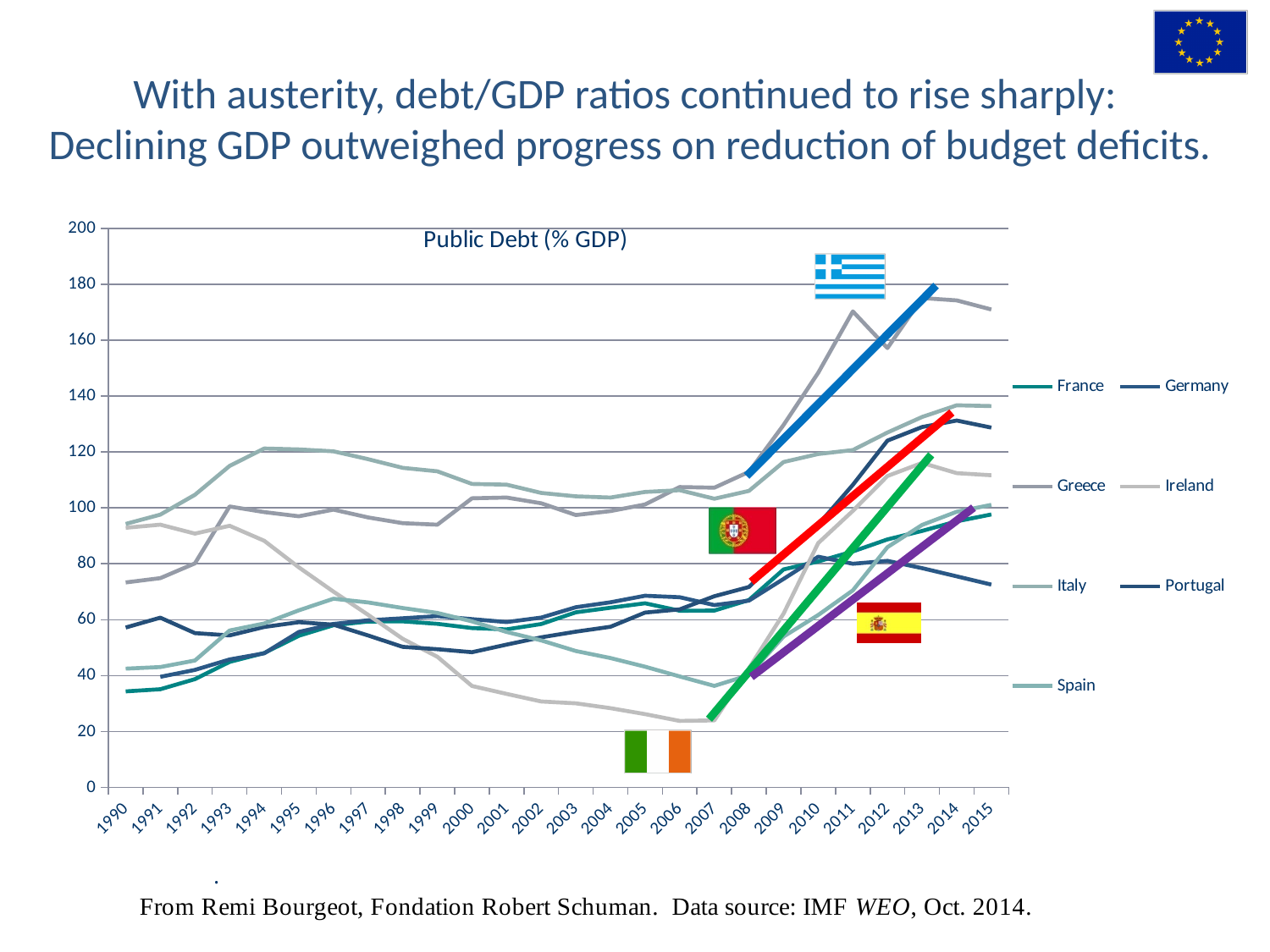
Which country has the highest public debt ratio in 2015? Greece How many years are shown along the x axis? 26 In 2015, which is higher: France or Germany? France What kind of chart is shown on the slide? line chart Does the Greece line rise or fall between 2007 and 2011? rise Which country has the lowest public debt ratio in 2007? Ireland Is the value for Italy in 1994 greater or less than 100? greater Is the value for Ireland in 2007 greater or less than 40? less Which country has the lowest public debt ratio in 2015? Germany Is the value for Greece in 2015 greater or less than 160? greater How many series does the legend list? 7 What is the title of the chart? Public Debt (% GDP)